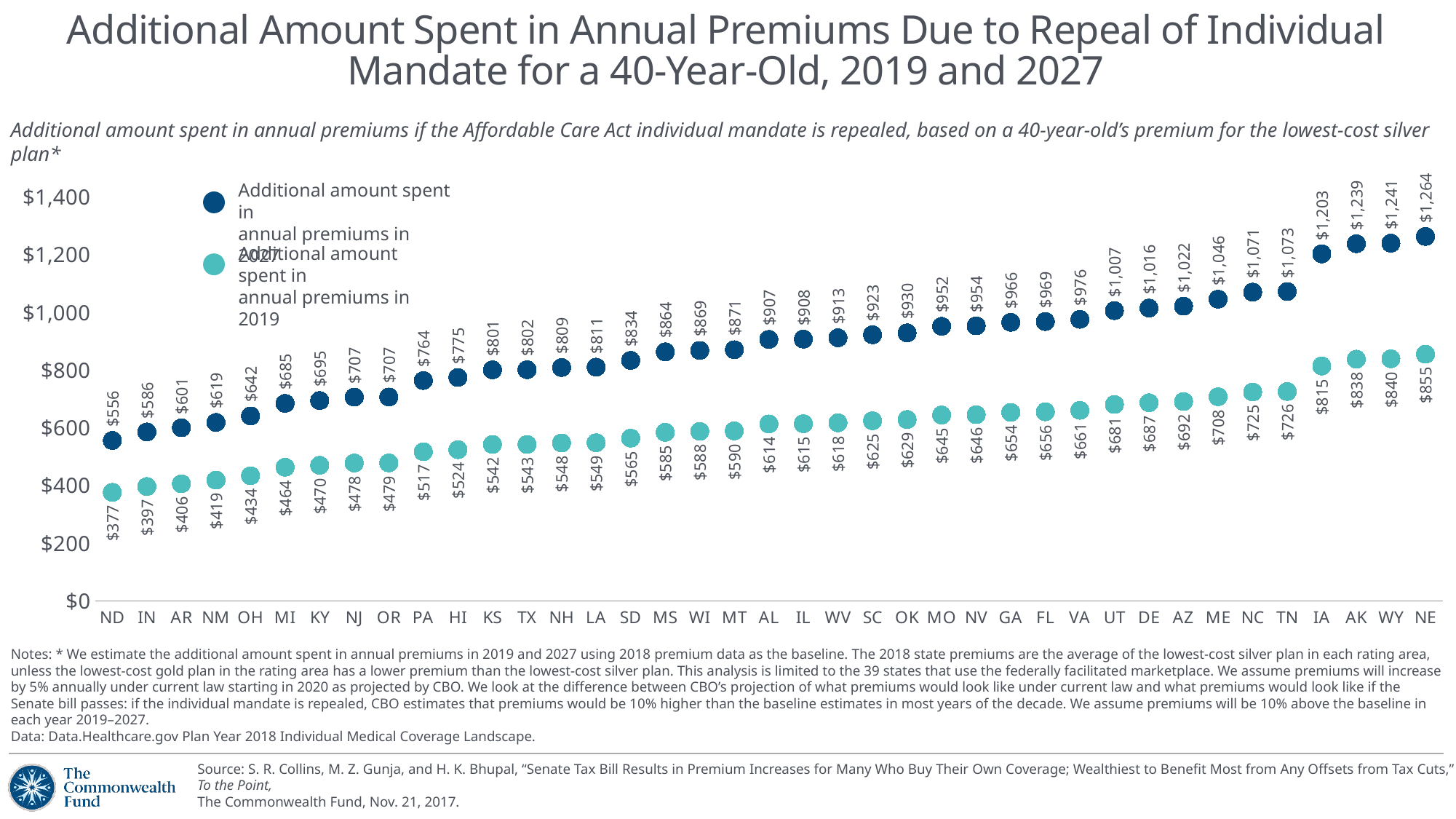
For ND, what is the difference between the 2027 and 2019 additional amounts? $179 What is the additional amount spent in annual premiums in 2019 for NE? $855 Which state has the lowest additional amount spent in annual premiums in 2019? ND What is the additional amount spent in annual premiums in 2019 for TX? $543 For NE, how much larger is the 2027 additional amount than the 2019 additional amount? $409 Is the 2027 additional amount for MI greater or less than $600? greater What is the additional amount spent in annual premiums in 2027 for ND? $556 Do the 2019 additional amounts rise or fall from left to right across the states? rise How many states are shown on the x axis? 39 How many series does the legend list? 2 Which is larger: the 2027 additional amount for PA or for OH? PA Which state has the highest additional amount spent in annual premiums in 2027? NE